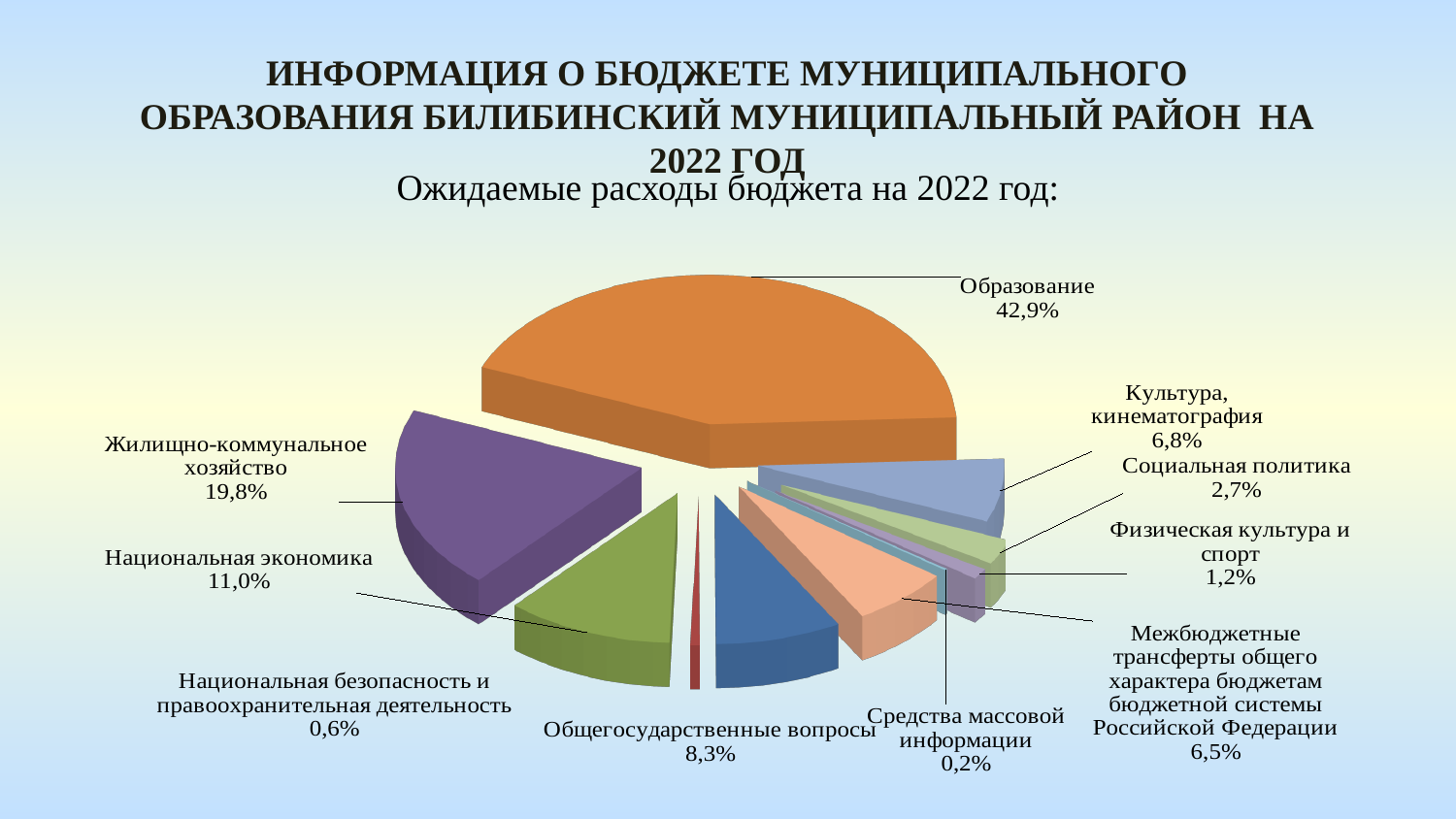
What share is labelled for Средства массовой информации? 0,2% What is the subtitle written above the pie chart? Ожидаемые расходы бюджета на 2022 год: What is the combined share of Общегосударственные вопросы and Национальная безопасность и правоохранительная деятельность? 8,9% What is the difference in percentage points between Образование and Жилищно-коммунальное хозяйство? 23,1 What share of expected 2022 budget expenditures goes to Образование? 42,9% Which category has the largest share of the pie? Образование What percentage is shown for Жилищно-коммунальное хозяйство? 19,8% Which is larger: the share for Культура, кинематография or the share for Социальная политика? Культура, кинематография Which category has the smallest share of the pie? Средства массовой информации What percentage is shown for Национальная экономика? 11,0% What type of chart is shown on the slide? Pie chart How many categories are shown in the pie chart? 10